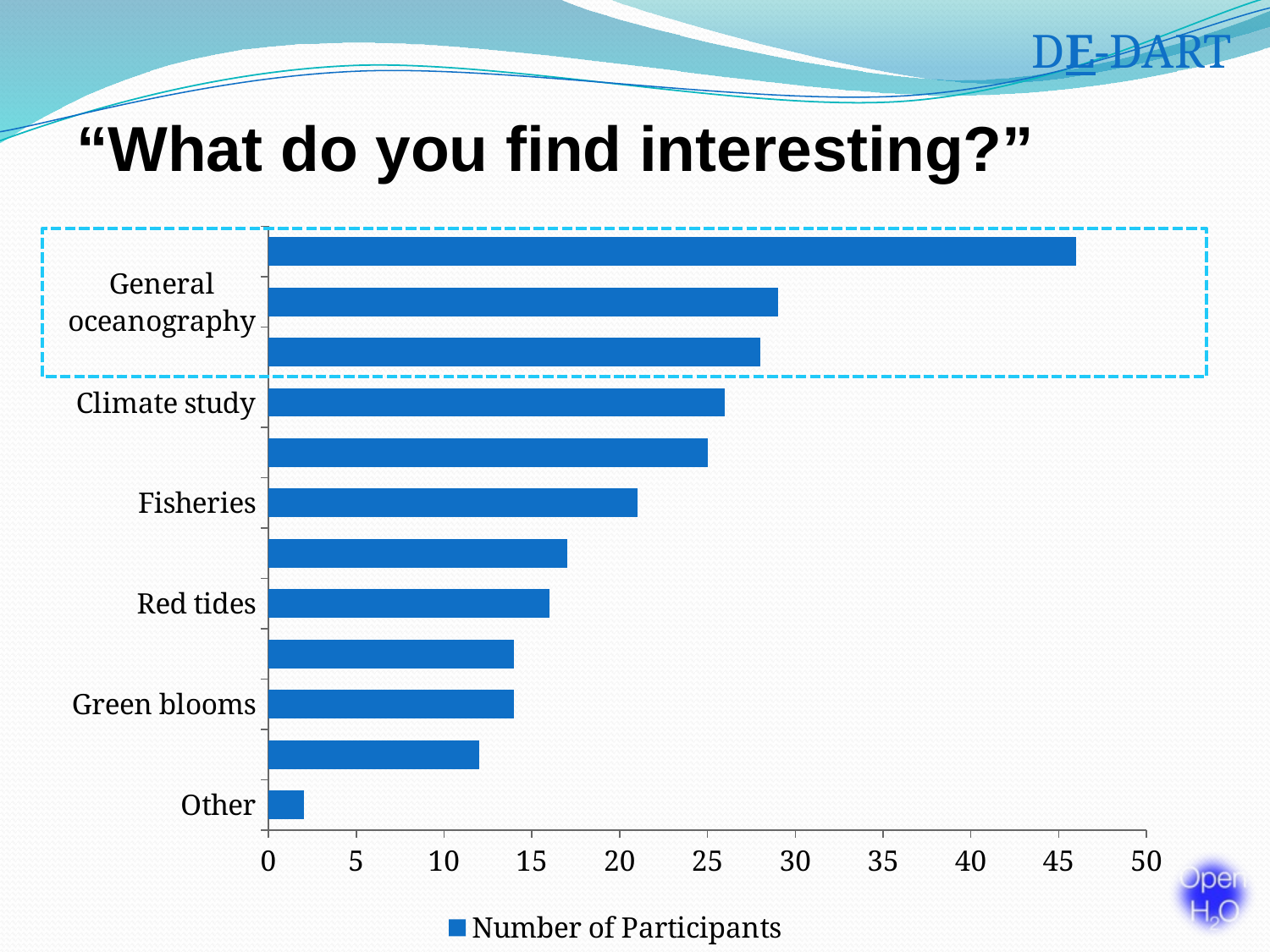
How many series does the legend list? 1 Which is larger, the value for Climate study or the value for Fisheries? Climate study Is the value for Red tides greater or less than 20? less Is the value for Climate study greater or less than 30? less Is the value for Other greater or less than 5? less What is the legend entry for the series in the chart? Number of Participants How many bars are plotted in the chart? 12 Which labelled category has the lowest value? Other What is the title of the slide containing the chart? "What do you find interesting?" What kind of chart is shown on the slide? bar chart Do the bar lengths increase or decrease going from the top of the chart to the bottom? decrease